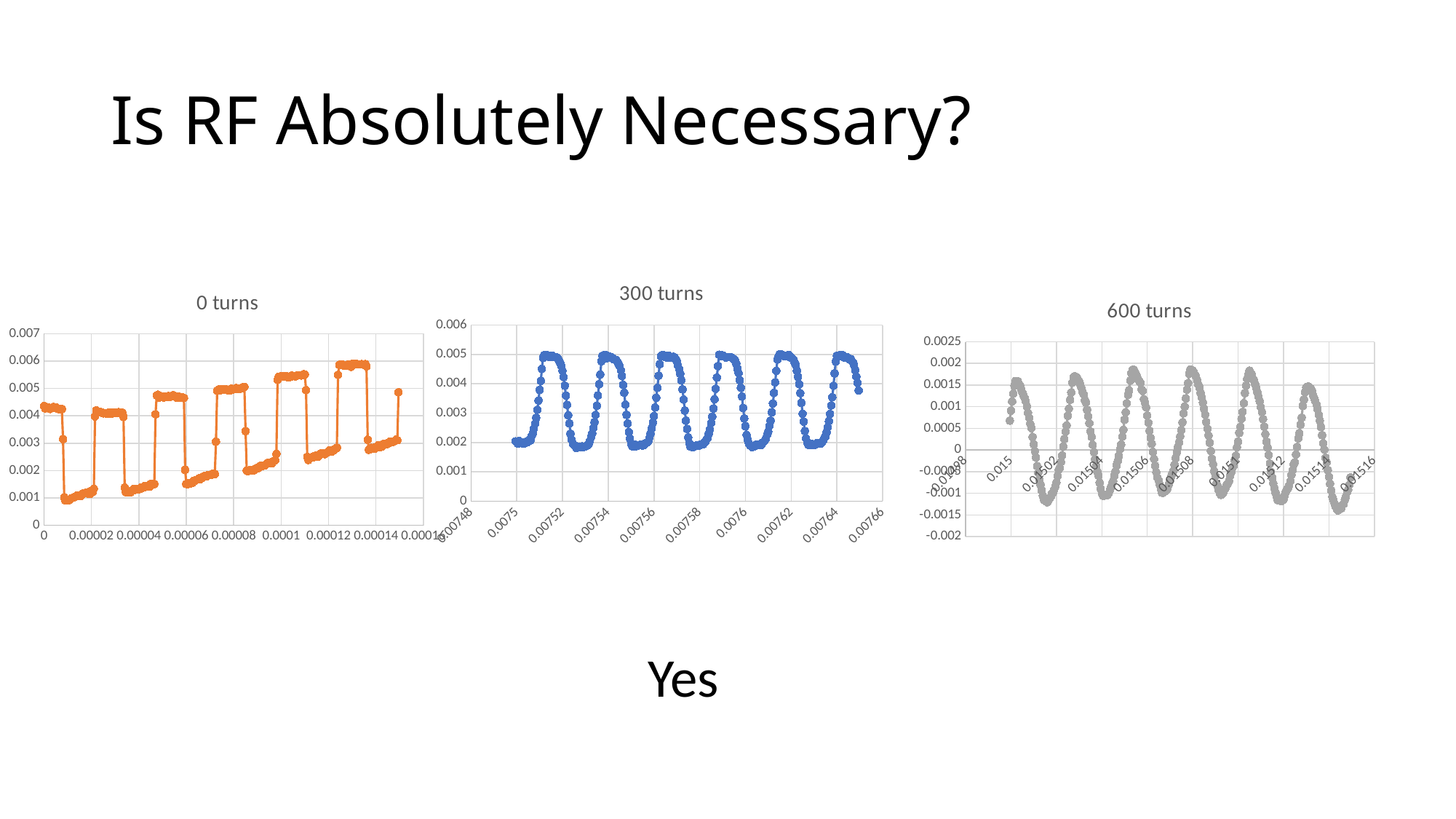
In the '0 turns' chart, is the highest plotted value greater or less than 0.005? greater In the '0 turns' chart, is the lowest plotted value greater or less than 0.002? less What kind of chart is the '300 turns' chart? scatter chart In the '300 turns' chart, is the highest plotted value greater or less than 0.004? greater How many charts are shown on the slide? 3 What is the title of the leftmost chart? 0 turns Which of the three charts has a y axis that extends to negative values? 600 turns In the '0 turns' chart, do the plotted values generally rise or fall as x increases? rise What is the highest y-axis tick label on the '0 turns' chart? 0.007